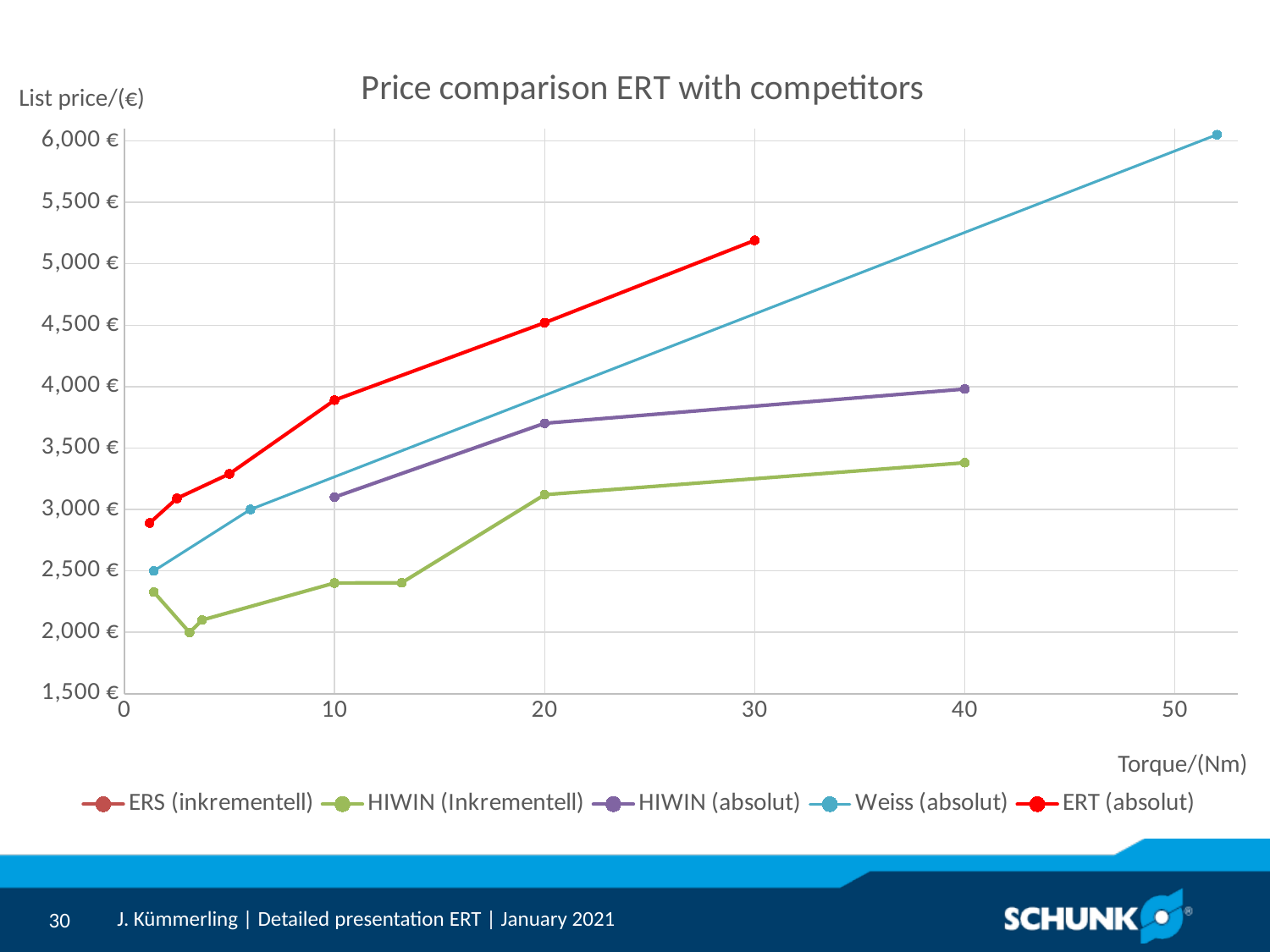
Is the value for HIWIN (Inkrementell) at 40 Nm greater or less than 3,500 €? less Is the value for ERT (absolut) at 30 Nm greater or less than 5,000 €? greater How many series does the legend list? 5 Is the value for Weiss (absolut) at its highest torque point greater or less than 5,500 €? greater What kind of chart is shown on the slide? line chart At 20 Nm, which series has the higher list price: ERT (absolut) or HIWIN (absolut)? ERT (absolut) Does the list price for ERT (absolut) rise or fall as torque increases? rise What is the label of the x axis? Torque/(Nm) What is the title of the chart? Price comparison ERT with competitors How many data points are plotted for the ERT (absolut) series? 6 Which series reaches the highest list price on the chart? Weiss (absolut)